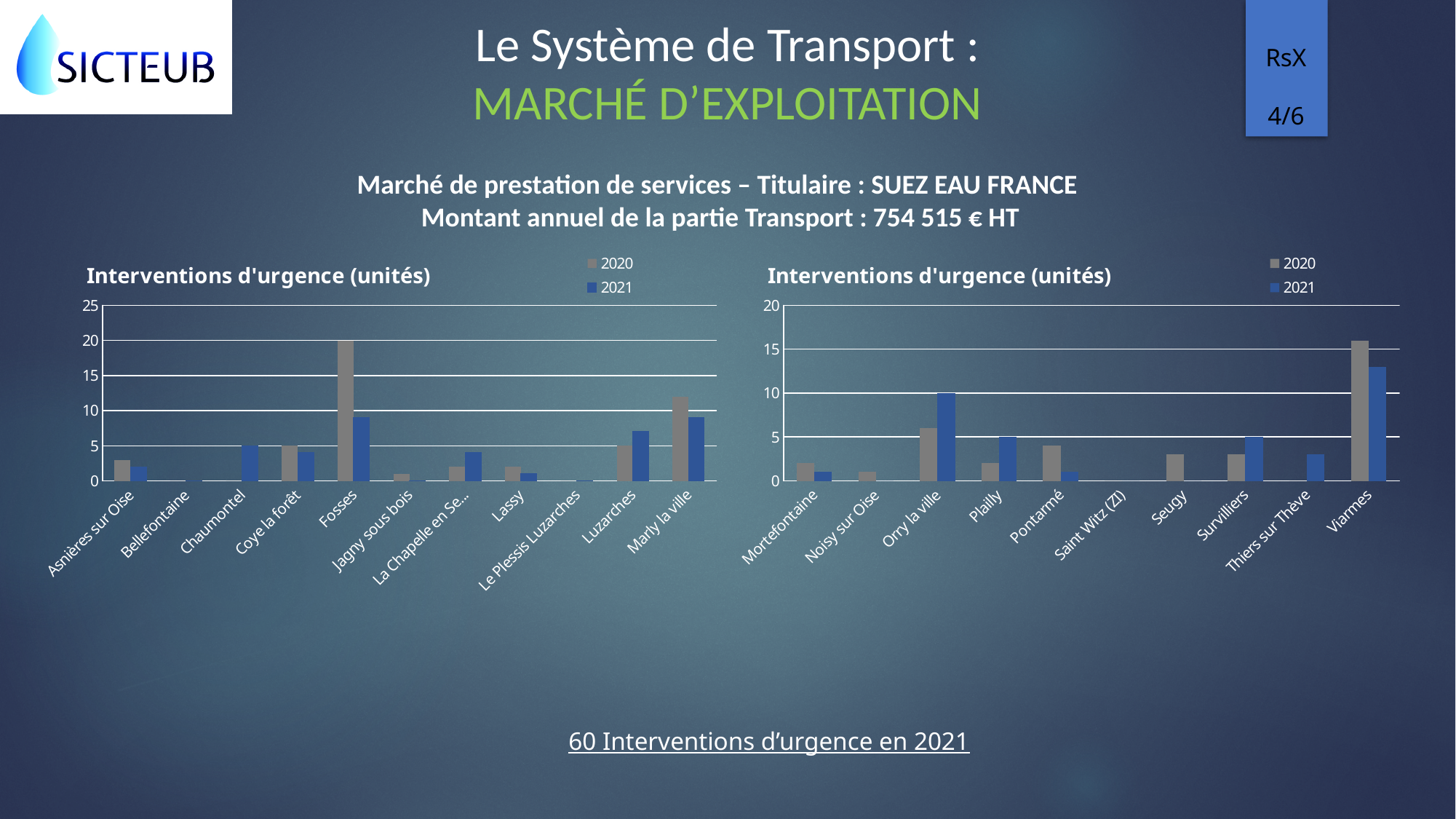
In the right chart, which is larger for Pontarmé: the 2020 value or the 2021 value? 2020 How many categories are shown on the x axis of the right chart? 10 In the right chart, which category has the highest 2021 value? Viarmes What kind of chart is the left chart on the slide? bar chart In the right chart, what is the 2021 value for Orry la ville? 10 In the left chart, which category has the highest 2020 value? Fosses In the left chart, is the 2020 value for Marly la ville greater or less than 10? greater In the left chart, which is larger for Luzarches: the 2020 value or the 2021 value? 2021 In the left chart, what is the 2020 value for Fosses? 20 How many categories are shown on the x axis of the left chart? 11 How many series does the legend of the right chart list? 2 In the right chart, is the 2020 value for Viarmes greater or less than 15? greater